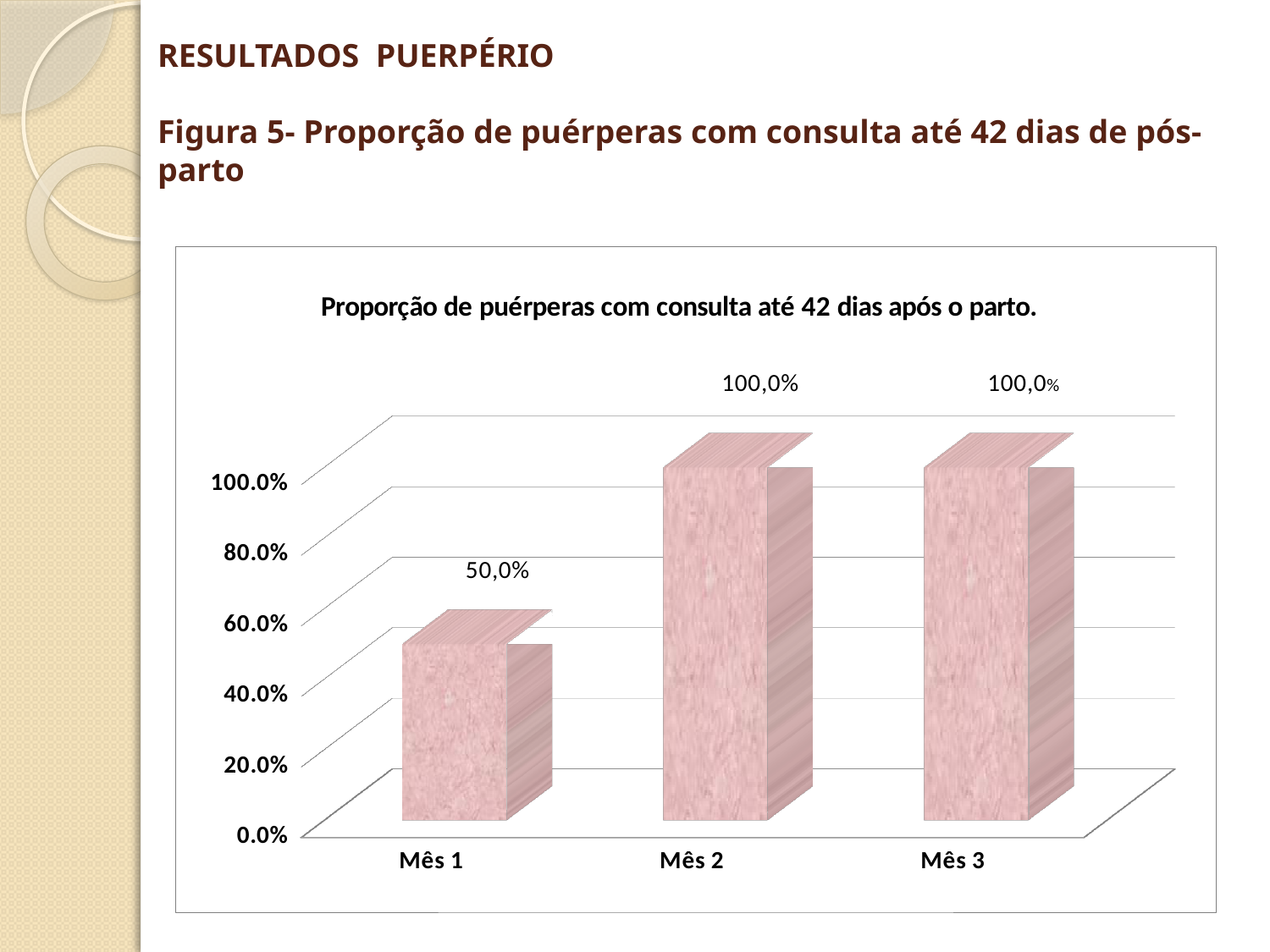
Which is larger, the value for Mês 1 or the value for Mês 2? Mês 2 What is the highest value labelled on the y axis? 100.0% Do the values rise or fall from Mês 1 to Mês 2? rise What is the difference between the values for Mês 2 and Mês 1? 50,0% How many categories are shown on the x axis? 3 What is the value for Mês 3? 100,0% What is the title of the chart? Proporção de puérperas com consulta até 42 dias após o parto. What kind of chart is shown? bar chart Which category has the lowest value? Mês 1 Is the value for Mês 1 greater or less than 80.0%? less What is the value for Mês 1? 50,0% What is the value for Mês 2? 100,0%